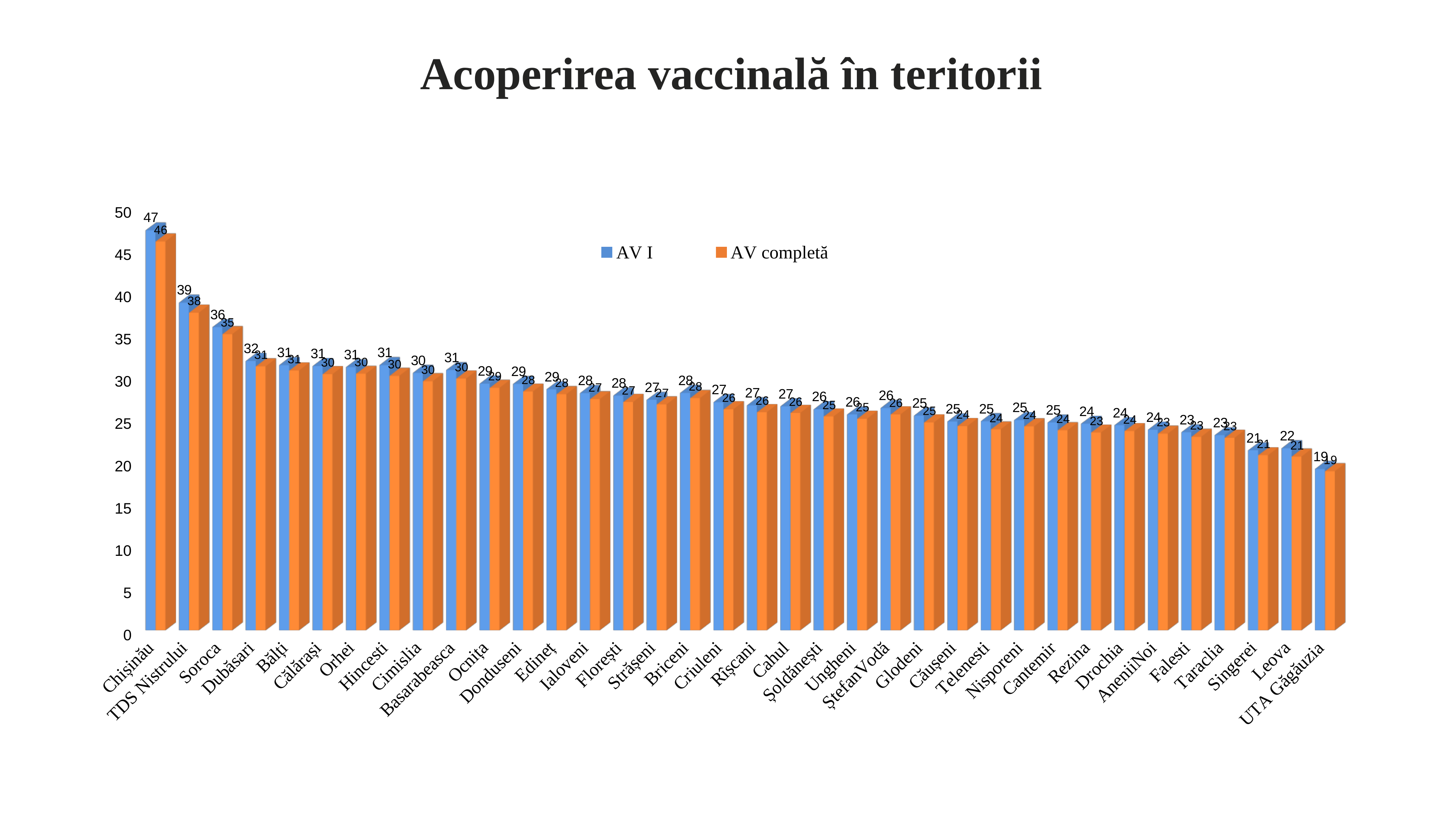
What is the AV I value for Chișinău? 47 How many territories are shown on the x axis? 36 What is the difference between the AV I and AV completă values for TDS Nistrului? 1 How many series does the legend list? 2 What is the difference between the AV I values for Chișinău and Soroca? 11 Which territory has the highest AV I value? Chișinău Which territory has the lowest AV completă value? UTA Găgăuzia What kind of chart is shown on the slide? Bar chart Do the AV I values generally rise or fall from left to right along the x axis? Fall What is the AV completă value for Soroca? 35 Which is larger, the AV I value for Dubăsari or the AV I value for Cahul? Dubăsari What is the AV I value for Leova? 22